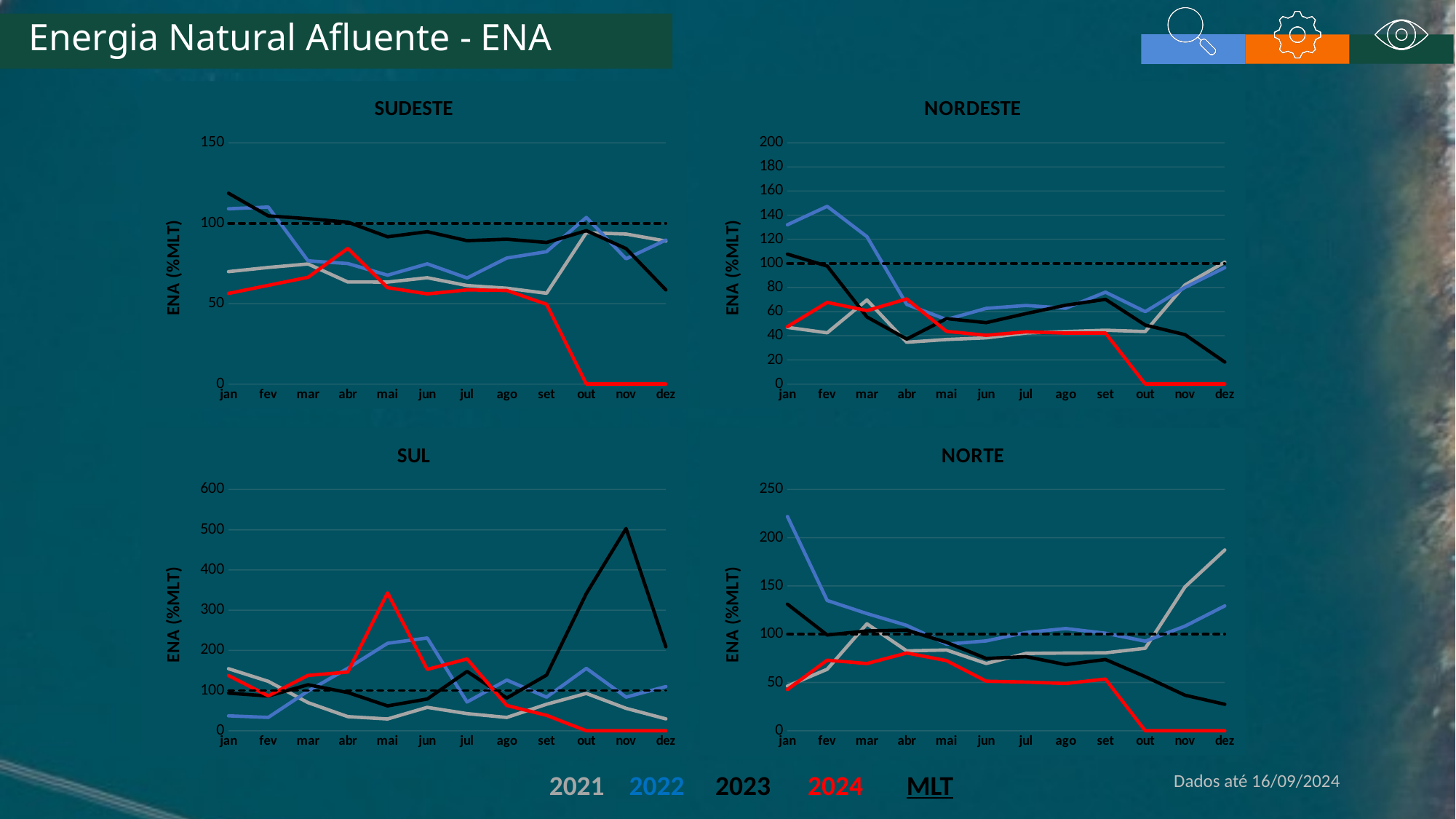
In the SUL chart, which month has the highest 2023 value? nov In the NORTE chart, which month has the highest 2021 value? dez How many series does the legend at the bottom of the slide list? 5 In the NORTE chart, in dez, which is higher: the 2021 value or the 2022 value? 2021 At what value on the y axis is the dashed MLT line drawn in the SUDESTE chart? 100 How many months are shown on the x axis of the SUL chart? 12 What kind of chart is the SUDESTE chart? line chart In the NORDESTE chart, does the 2024 line rise or fall from set to out? fall In the NORTE chart, is the 2022 value for jan greater or less than 200? greater In the SUL chart, which month has the highest 2024 value? mai In the SUDESTE chart, is the 2024 value for set greater or less than 100? less In the SUL chart, is the 2023 value for nov greater or less than 400? greater